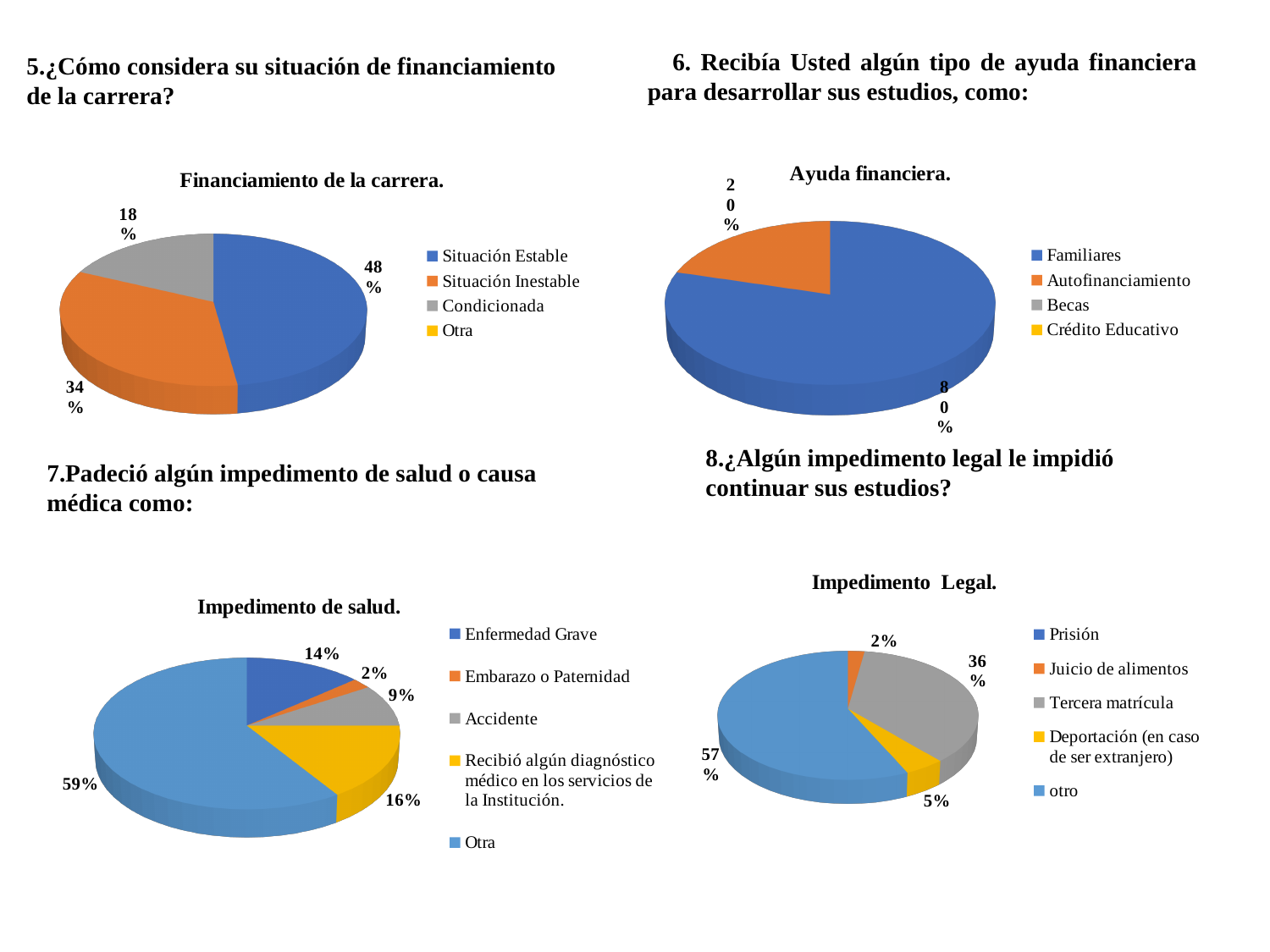
In the 'Financiamiento de la carrera.' chart, what is the difference between Situación Estable and Situación Inestable? 14% In the 'Impedimento de salud.' chart, what percentage is shown for Otra? 59% In the 'Impedimento Legal.' chart, what is the difference between otro and Deportación (en caso de ser extranjero)? 52% In the 'Ayuda financiera.' chart, what percentage is shown for Familiares? 80% In the 'Financiamiento de la carrera.' chart, what percentage is shown for Situación Estable? 48% In the 'Ayuda financiera.' chart, which category has the largest slice? Familiares How many entries does the legend of the 'Ayuda financiera.' chart list? 4 In the 'Impedimento de salud.' chart, which is larger: Enfermedad Grave or Accidente? Enfermedad Grave What type of chart is 'Impedimento Legal.'? Pie chart In the 'Financiamiento de la carrera.' chart, what percentage is shown for Condicionada? 18% In the 'Impedimento de salud.' chart, which category has the smallest slice? Embarazo o Paternidad In the 'Impedimento Legal.' chart, what percentage is shown for Tercera matrícula? 36%